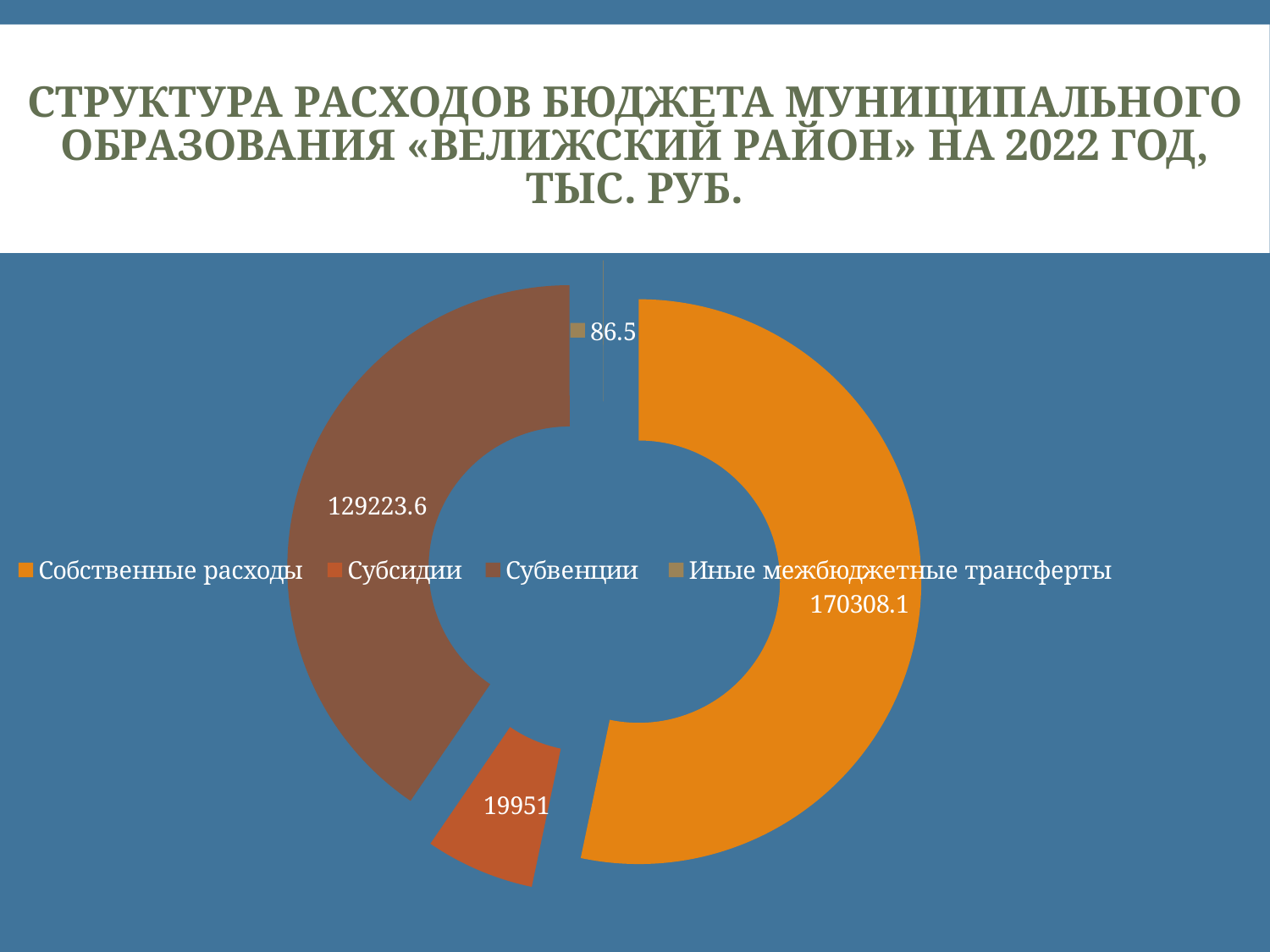
Which is larger, Субсидии or Субвенции? Субвенции What is the difference between Субвенции and Субсидии? 109272.6 Which category has the smallest value? Иные межбюджетные трансферты What is the value for Субвенции? 129223.6 Which category has the largest value? Собственные расходы What is the value for Субсидии? 19951 What is the value for Собственные расходы? 170308.1 What type of chart is shown on the slide? doughnut chart How many categories does the chart show? 4 What is the difference between Собственные расходы and Субвенции? 41084.5 What is the total of all four categories shown in the chart? 319569.2 What is the value for Иные межбюджетные трансферты? 86.5